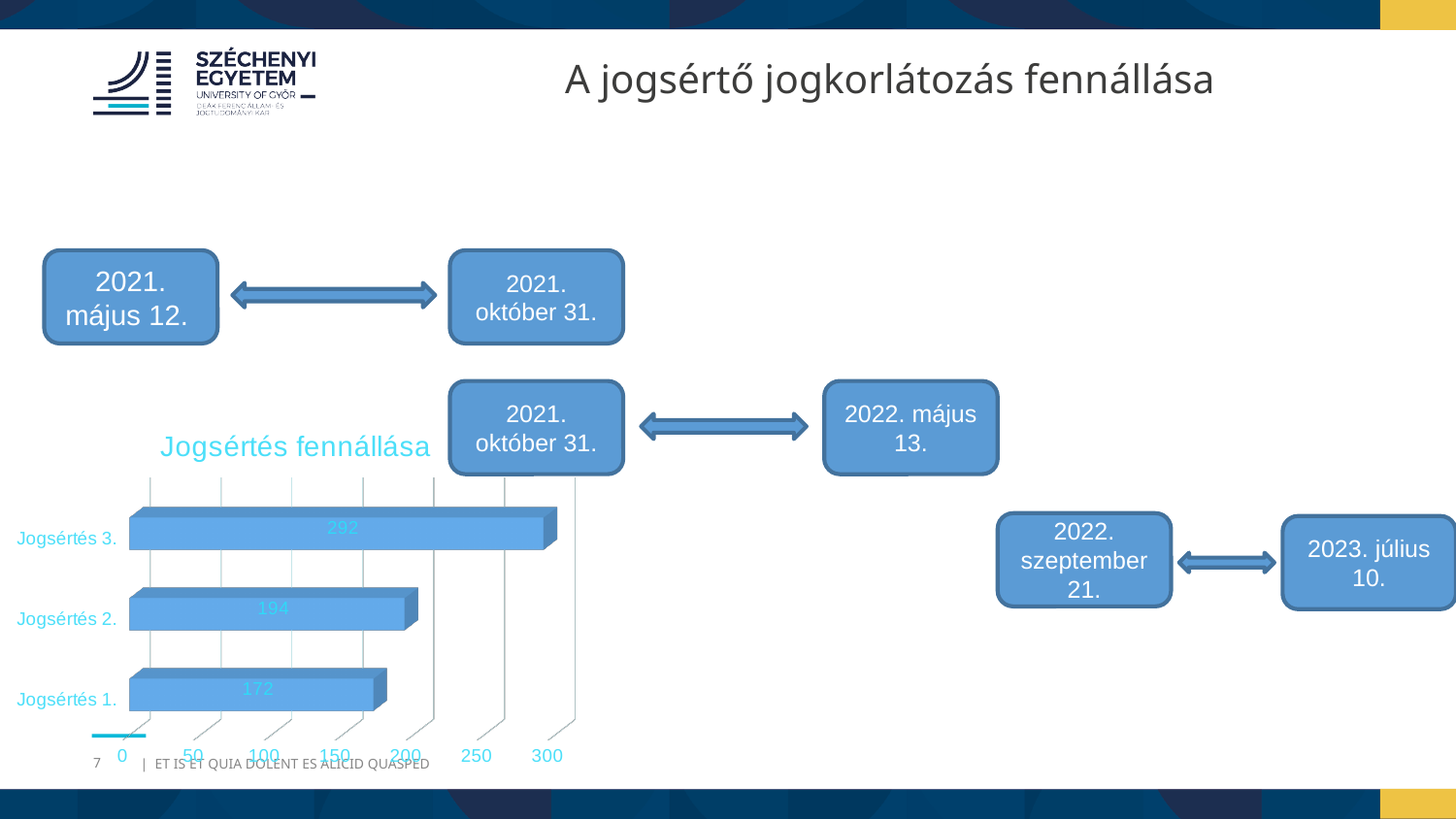
Which category has the highest value in the chart? Jogsértés 3. Is the value for Jogsértés 3. greater or less than 250? greater Which category has the lowest value in the chart? Jogsértés 1. What is the difference between the values for Jogsértés 3. and Jogsértés 2.? 98 What is the value for Jogsértés 3. in the chart? 292 What kind of chart is shown on the slide? bar chart What is the title of the chart? Jogsértés fennállása What is the value for Jogsértés 1. in the chart? 172 Which is larger, the value for Jogsértés 2. or Jogsértés 1.? Jogsértés 2. How many categories are shown in the chart? 3 What is the value for Jogsértés 2. in the chart? 194 What is the difference between the values for Jogsértés 2. and Jogsértés 1.? 22